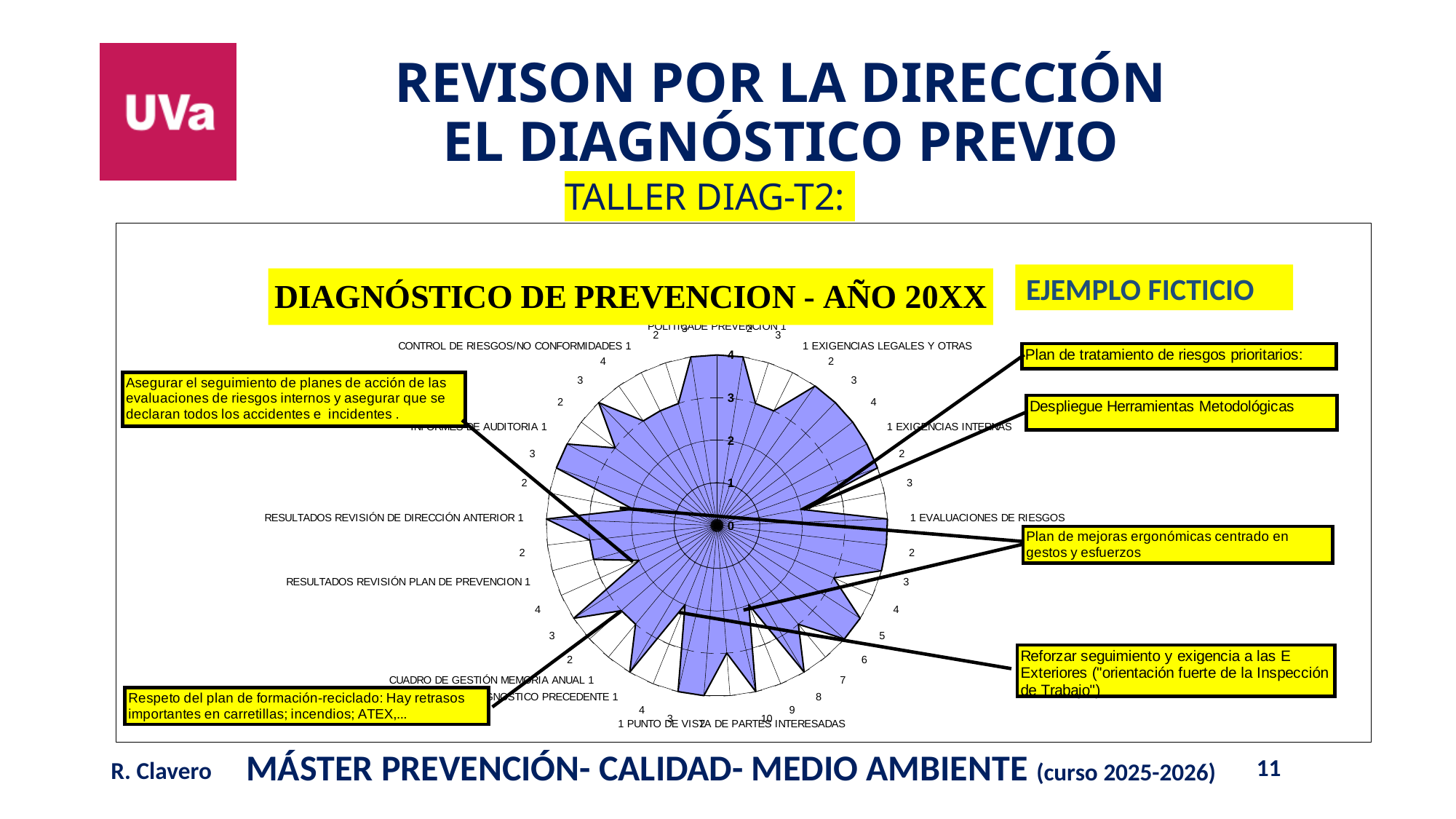
What is the title of the chart? DIAGNÓSTICO DE PREVENCION - AÑO 20XX Is the value for POLITICA DE PREVENCION 1 greater or less than 3? greater Is the value for 1 EVALUACIONES DE RIESGOS greater or less than 2? greater Is the value for RESULTADOS REVISIÓN DE DIRECCIÓN ANTERIOR 1 greater or less than 2? greater What kind of chart is shown on the slide? Radar chart What is the highest value marked on the chart's radial axis? 4